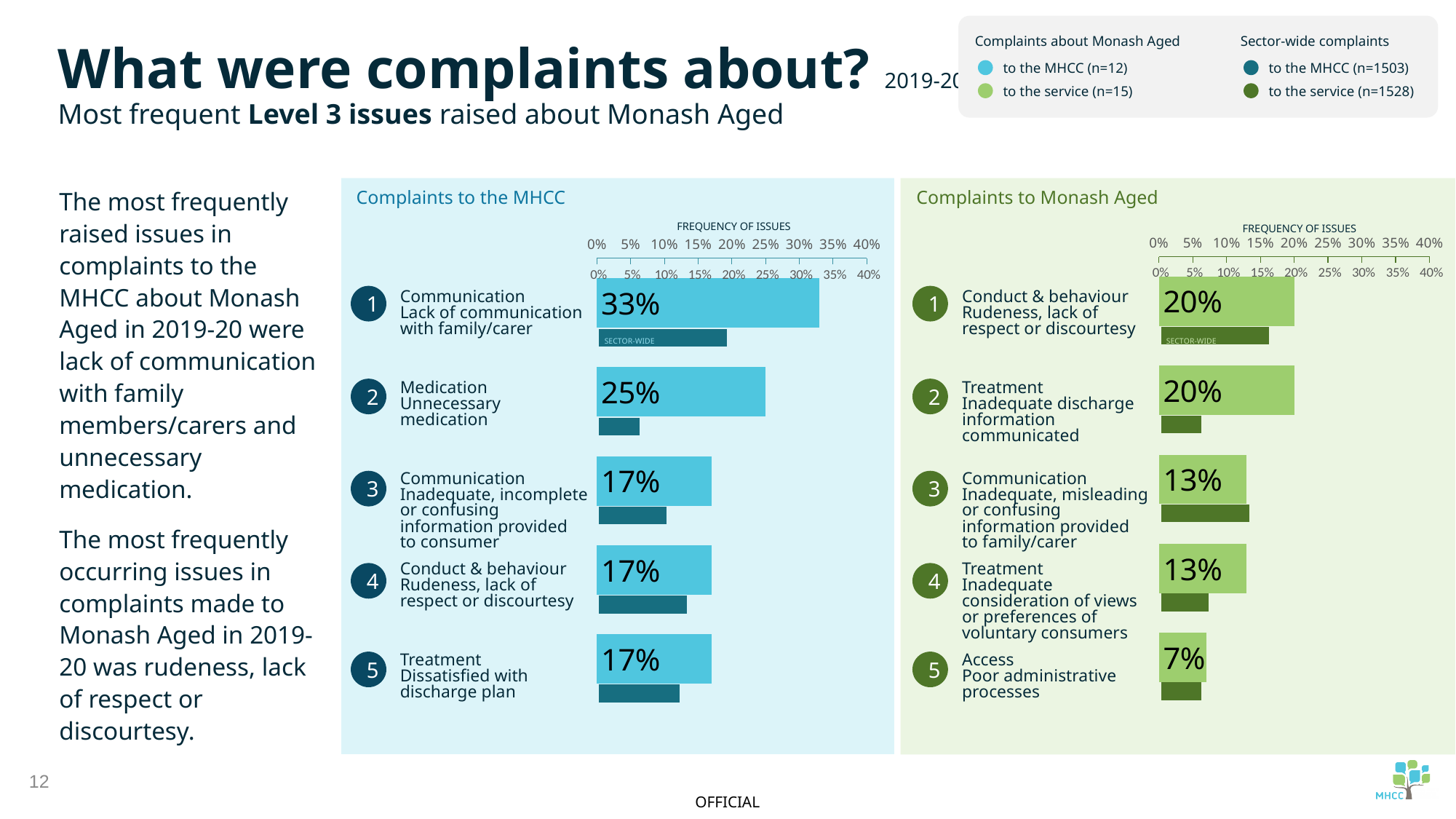
In the 'Complaints to the MHCC' chart, what is the difference between the frequency for Communication – Lack of communication with family/carer and Medication – Unnecessary medication? 8% How many issues are listed in the 'Complaints to Monash Aged' chart? 5 In the 'Complaints to Monash Aged' chart, which issue has the lowest frequency? Access – Poor administrative processes What type of chart is used in the 'Complaints to the MHCC' panel? Bar chart In the 'Complaints to Monash Aged' chart, what is the frequency for Access – Poor administrative processes? 7% In the 'Complaints to the MHCC' chart, is the sector-wide value for Medication – Unnecessary medication greater or less than 10%? less In the 'Complaints to the MHCC' chart, what is the frequency for Medication – Unnecessary medication? 25% In the 'Complaints to Monash Aged' chart, what is the difference between the frequency for Treatment – Inadequate discharge information communicated and Access – Poor administrative processes? 13% Which is larger: the frequency for Medication – Unnecessary medication in the 'Complaints to the MHCC' chart or the frequency for Conduct & behaviour in the 'Complaints to Monash Aged' chart? Medication – Unnecessary medication (Complaints to the MHCC) In the 'Complaints to Monash Aged' chart, what is the frequency for Conduct & behaviour – Rudeness, lack of respect or discourtesy? 20% In the 'Complaints to the MHCC' chart, which issue has the highest frequency? Communication – Lack of communication with family/carer In the 'Complaints to the MHCC' chart, what is the frequency for Communication – Lack of communication with family/carer? 33%